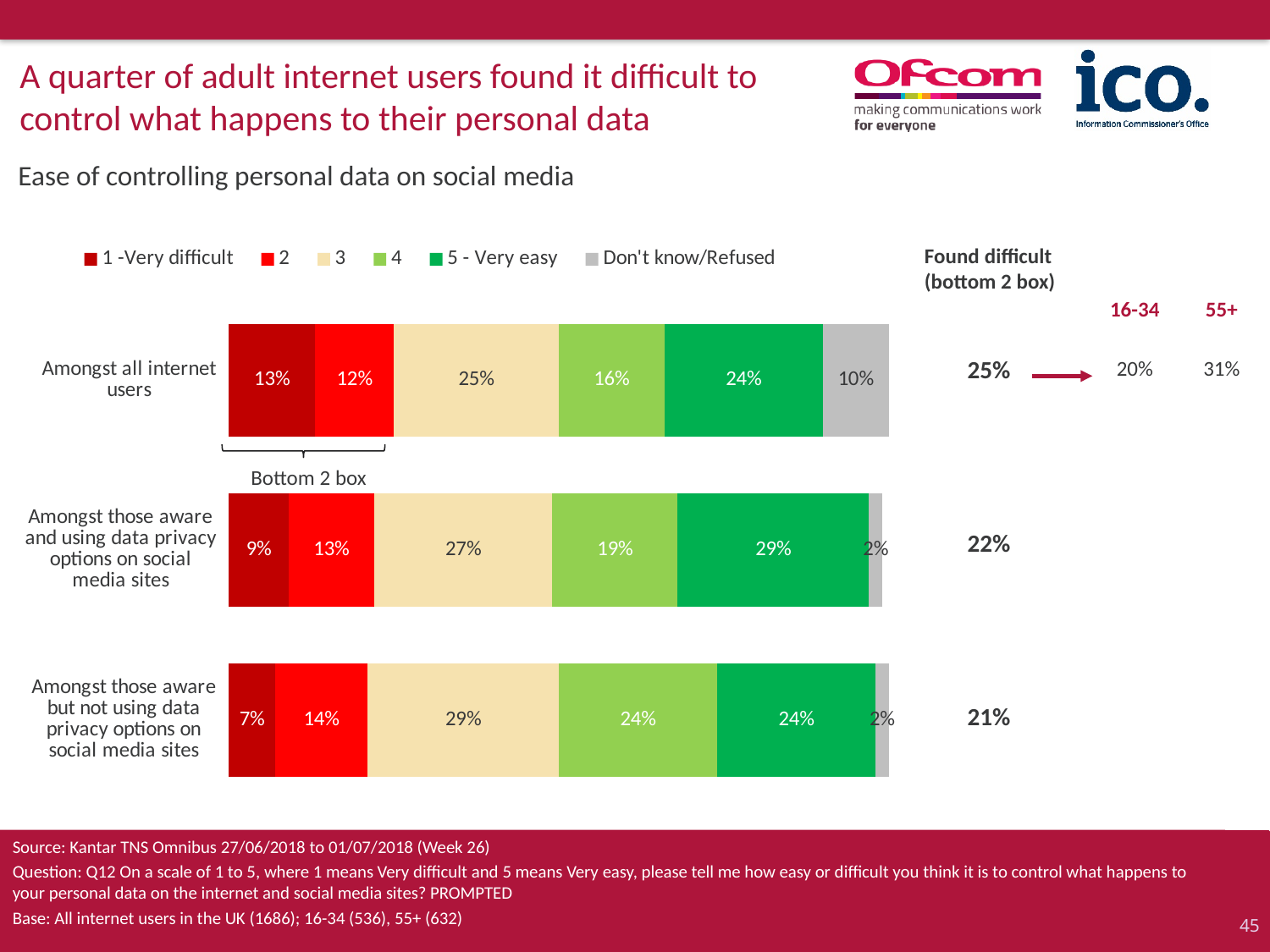
What percentage of all internet users answered '5 - Very easy'? 24% How many series does the legend list? 6 What is the value for '3' amongst those aware and using data privacy options on social media sites? 27% What is the 'Found difficult' figure for the 55+ age group? 31% What is the difference in the '5 - Very easy' value between those aware and using data privacy options (29%) and those aware but not using them (24%)? 5 percentage points Which category has the highest value for '1 - Very difficult'? Amongst all internet users What is the combined total of the '1 - Very difficult' and '2' segments for those aware but not using data privacy options on social media sites? 21% What is the 'Found difficult (bottom 2 box)' figure for all internet users? 25% Which has the larger value for '4': amongst all internet users or amongst those aware but not using data privacy options? Amongst those aware but not using data privacy options How many categories (bars) are plotted in the chart? 3 What is the 'Don't know/Refused' value amongst all internet users? 10% What kind of chart is shown on the slide? bar chart